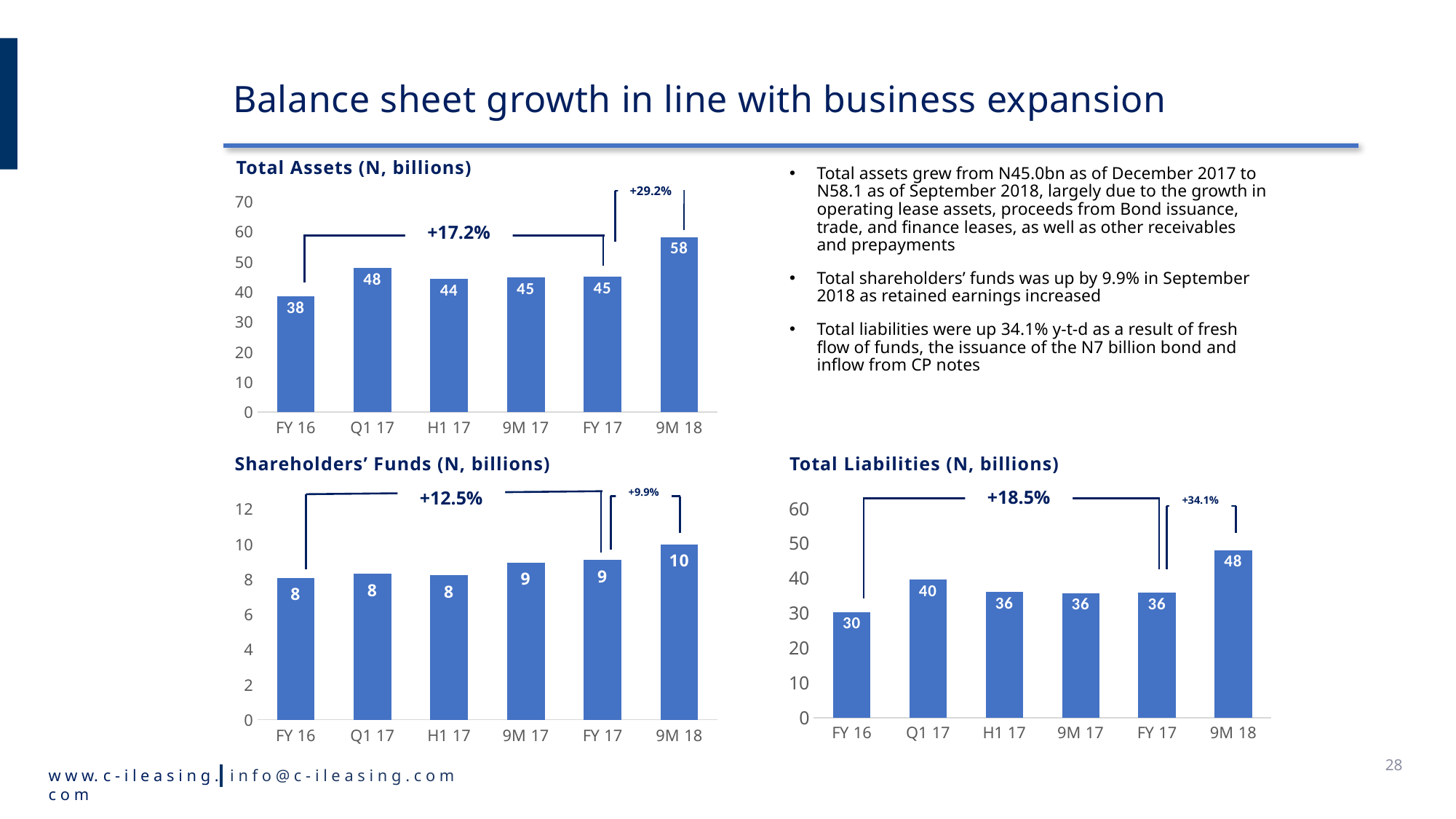
What type of chart is the Total Liabilities (N, billions) chart? Bar chart In the Shareholders' Funds (N, billions) chart, what growth percentage is annotated between FY 17 and 9M 18? +9.9% In the Total Assets (N, billions) chart, how many periods are shown on the x axis? 6 In the Total Assets (N, billions) chart, what is the difference between the 9M 18 and FY 17 values? 13 In the Total Assets (N, billions) chart, what is the value for 9M 18? 58 In the Total Liabilities (N, billions) chart, what is the value for Q1 17? 40 In the Shareholders' Funds (N, billions) chart, what is the value for 9M 18? 10 In the Total Liabilities (N, billions) chart, is the value for 9M 18 greater or less than Q1 17? greater In the Total Liabilities (N, billions) chart, which period has the lowest value? FY 16 In the Shareholders' Funds (N, billions) chart, which period has the highest value? 9M 18 In the Total Liabilities (N, billions) chart, what is the difference between the 9M 18 and FY 17 values? 12 In the Total Assets (N, billions) chart, which period has the lowest value? FY 16